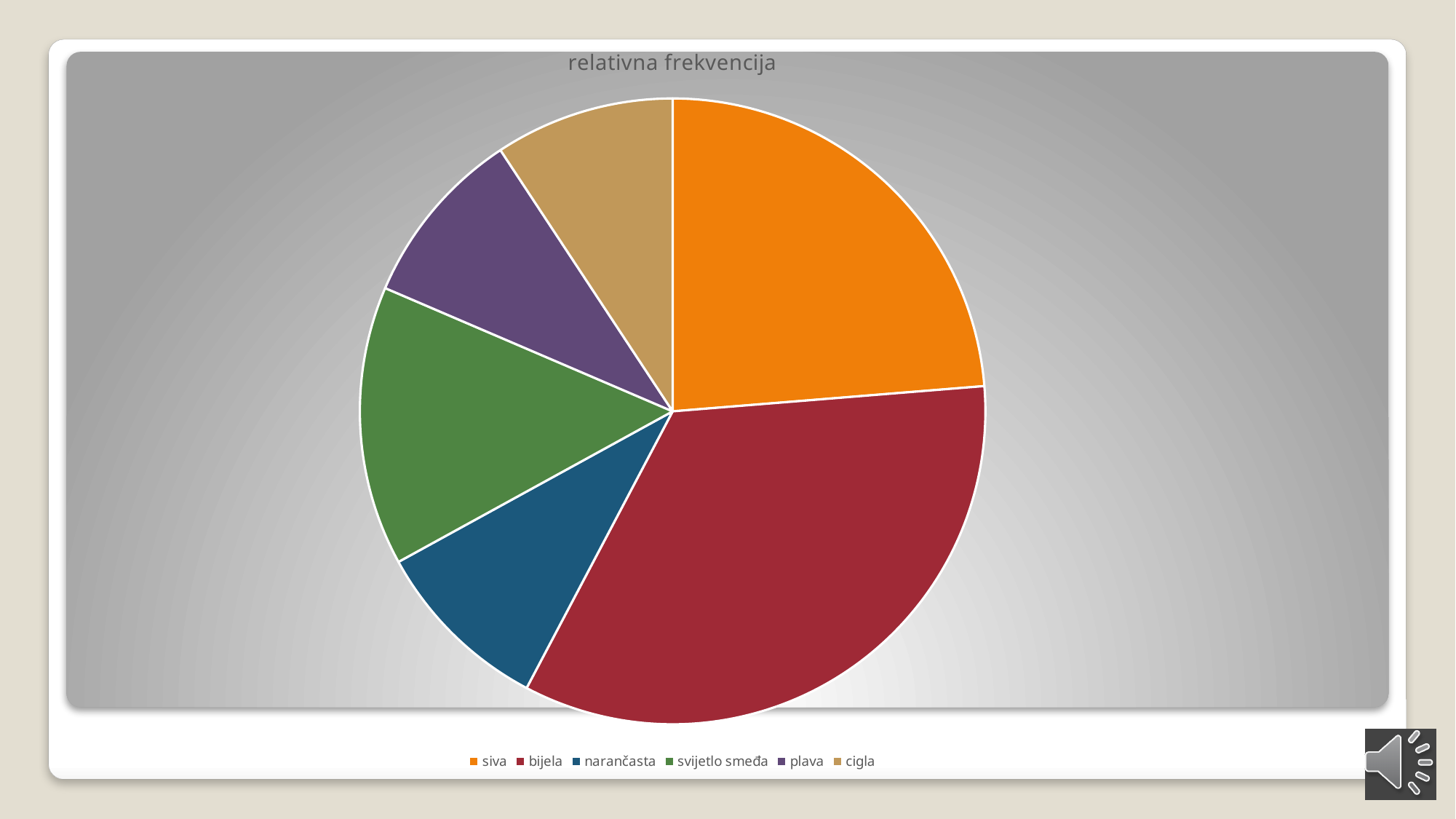
How many slices does the pie chart have? 6 Which slice is larger, siva or narančasta? siva Which category has the largest slice of the pie? bijela What is the title of the chart? relativna frekvencija What kind of chart is shown on the slide? pie chart Which slice is larger, bijela or plava? bijela Which slice is larger, svijetlo smeđa or narančasta? svijetlo smeđa How many entries does the legend list? 6 What colour is the slice for bijela? red